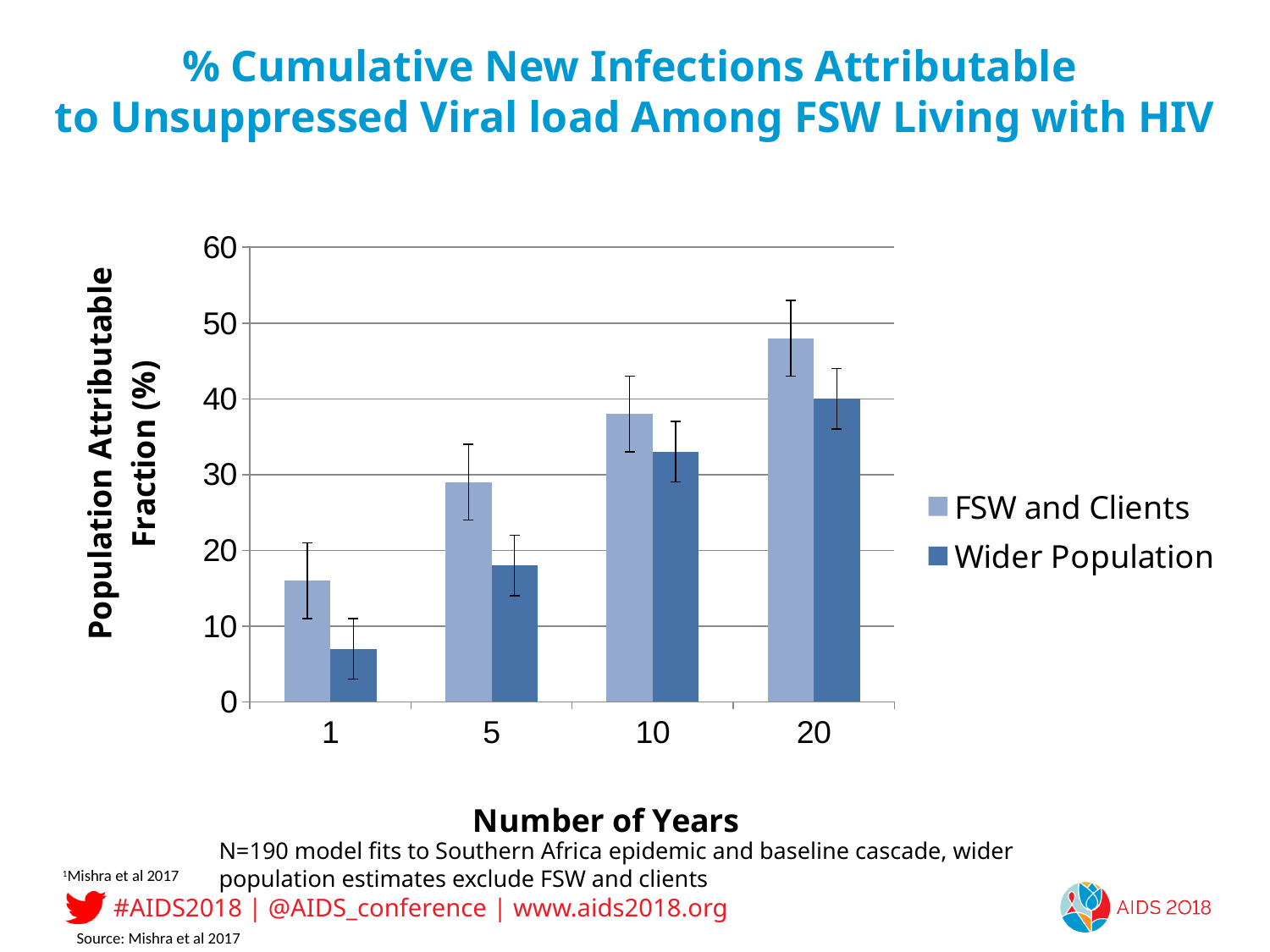
How many series does the legend list? 2 Is the value for FSW and Clients at 1 year greater or less than 10? greater How many categories are shown on the x axis (Number of Years)? 4 Which number of years has the lowest value for Wider Population? 1 Is the value for Wider Population at 1 year greater or less than 10? less Which number of years has the highest value for FSW and Clients? 20 Do the values for Wider Population rise or fall as the number of years increases? rise Is the value for FSW and Clients at 20 years greater or less than 50? less What kind of chart is shown on the slide? bar chart At 10 years, which series has the larger value: FSW and Clients or Wider Population? FSW and Clients